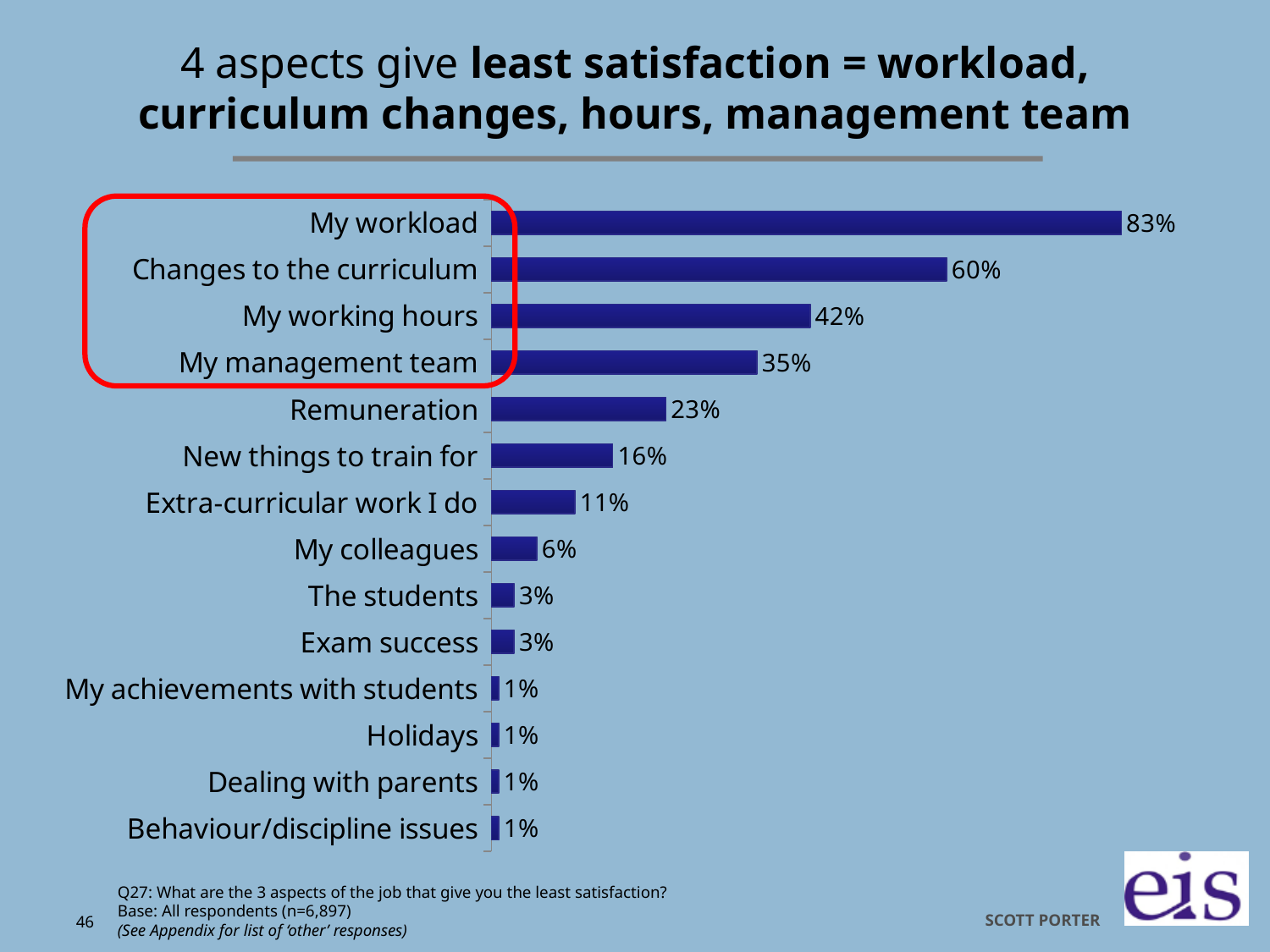
Which aspect has the highest percentage on the chart? My workload What is the value shown for 'My colleagues'? 6% What percentage of respondents selected 'My workload' as an aspect giving least satisfaction? 83% What is the difference in percentage points between 'My workload' and 'Changes to the curriculum'? 23 percentage points What percentage is shown for 'Remuneration'? 23% What type of chart is shown on the slide? Bar chart How many categories are enclosed by the red outline on the chart? 4 How many aspects (categories) are listed on the chart? 14 What is the difference between 'My working hours' and 'My management team'? 7 percentage points Which is larger, the value for 'New things to train for' or the value for 'Extra-curricular work I do'? New things to train for What is the value shown for 'Changes to the curriculum'? 60% What is the base (number of respondents) stated below the chart? n=6,897